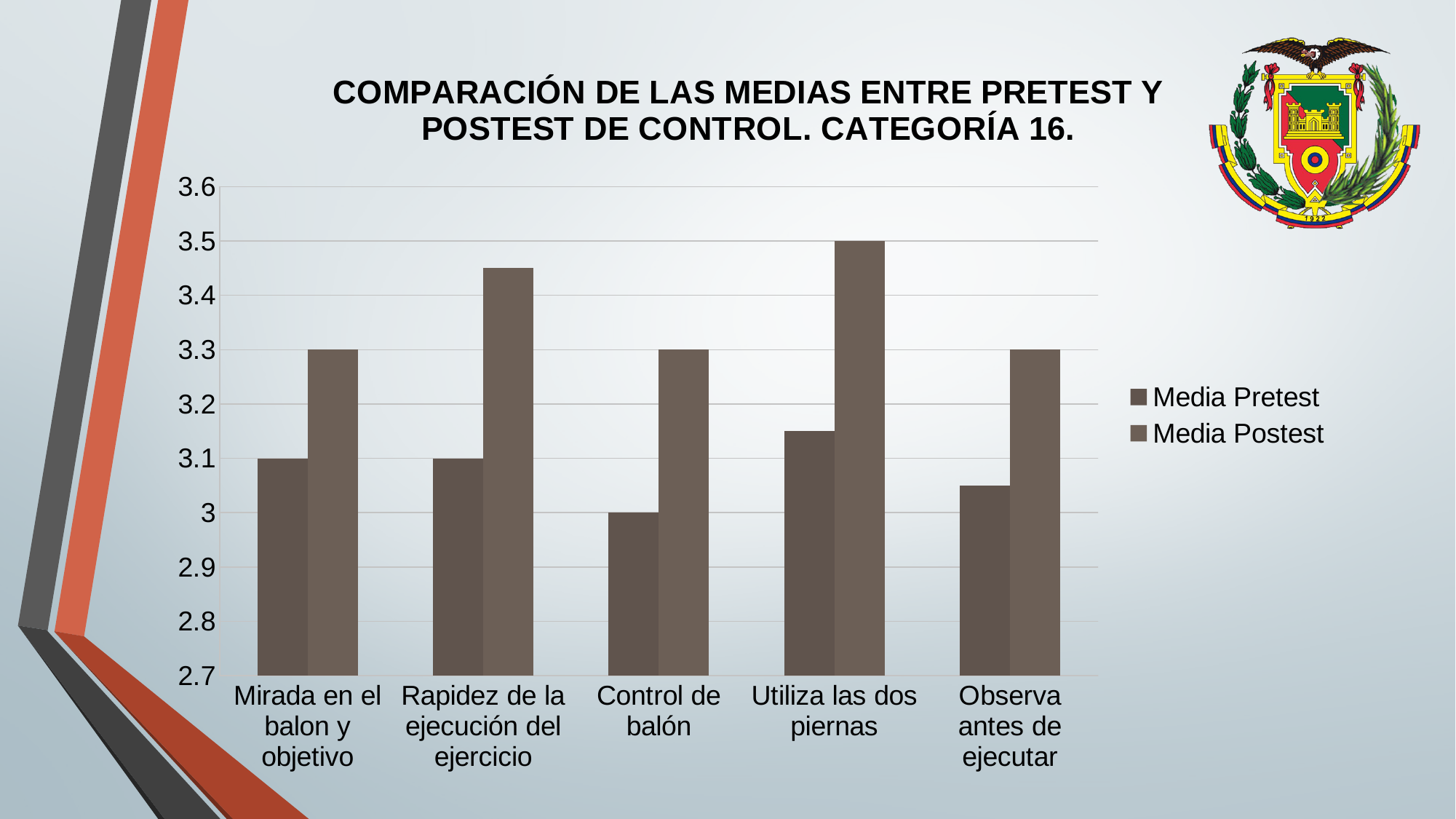
How many series does the legend list? 2 Which category has the lowest Media Pretest value? Control de balón What is the Media Postest value for 'Utiliza las dos piernas'? 3.5 How many categories are shown on the x axis? 5 What is the difference between the Media Postest and Media Pretest values for 'Mirada en el balon y objetivo'? 0.2 Which category has the highest Media Postest value? Utiliza las dos piernas Is the Media Postest value for 'Rapidez de la ejecución del ejercicio' greater or less than 3.4? greater What kind of chart is shown on the slide? bar chart Which is larger: the Media Postest value for 'Rapidez de la ejecución del ejercicio' or for 'Control de balón'? Rapidez de la ejecución del ejercicio What is the Media Postest value for 'Mirada en el balon y objetivo'? 3.3 What is the Media Pretest value for 'Control de balón'? 3 Is the Media Pretest value for 'Observa antes de ejecutar' greater or less than 3.1? less